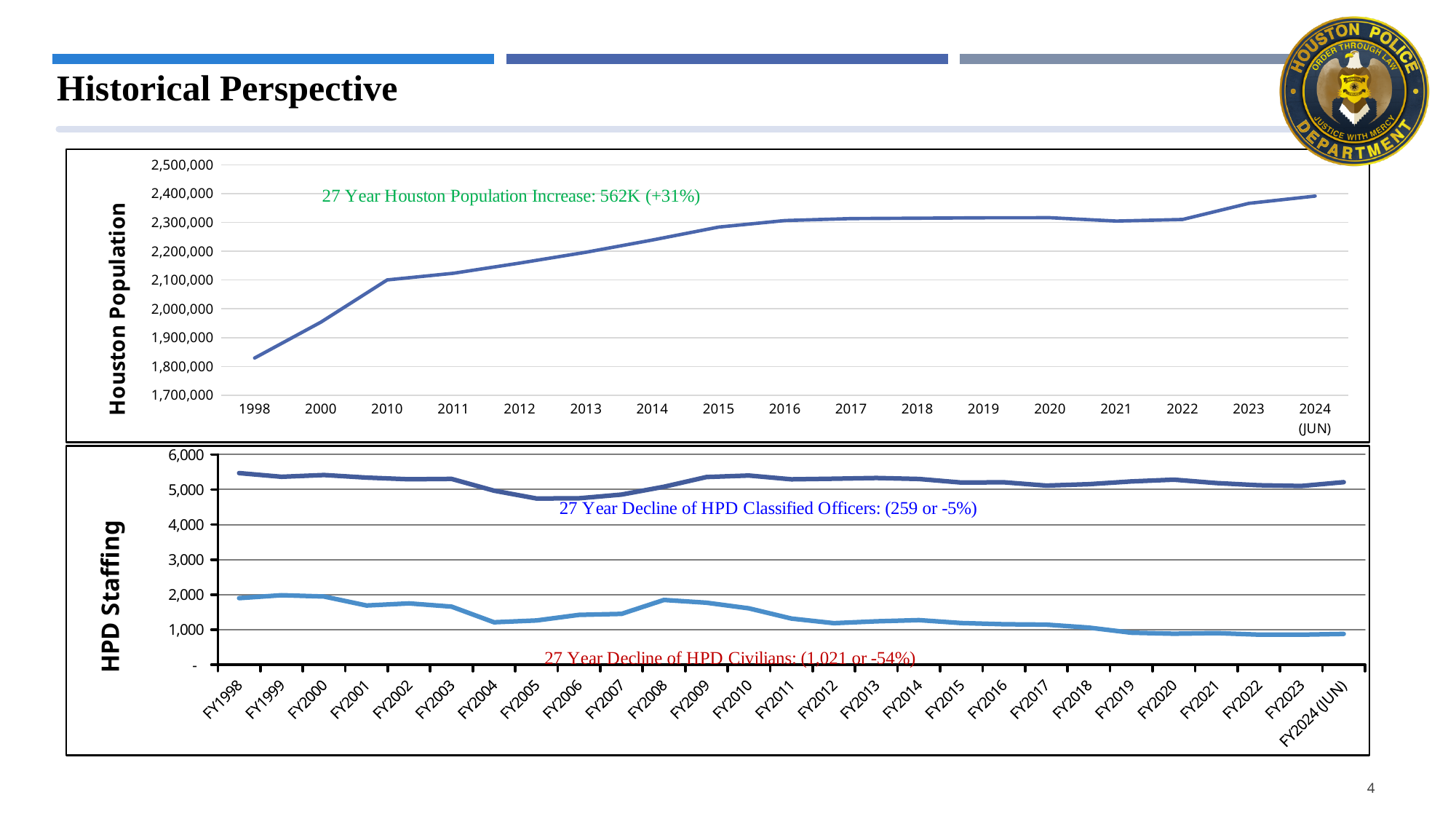
In the HPD Staffing chart, which line is higher in FY2010, HPD Classified Officers or HPD Civilians? HPD Classified Officers In the HPD Staffing chart, is the value for HPD Civilians in FY2024 (JUN) greater or less than 1,000? less In the HPD Staffing chart, is the value for HPD Classified Officers in FY2005 greater or less than 5,000? less In the Houston Population chart, is the value for 2024 (JUN) greater or less than 2,300,000? greater According to the annotation on the Houston Population chart, what is the 27 year Houston population increase? 562K (+31%) How many fiscal years are labelled on the x axis of the HPD Staffing chart? 27 How many years are labelled on the x axis of the Houston Population chart? 17 What kind of chart is the Houston Population chart at the top of the slide? line chart In the Houston Population chart, does the population generally rise or fall from 1998 to 2024 (JUN)? rise How many lines are plotted in the HPD Staffing chart at the bottom of the slide? 2